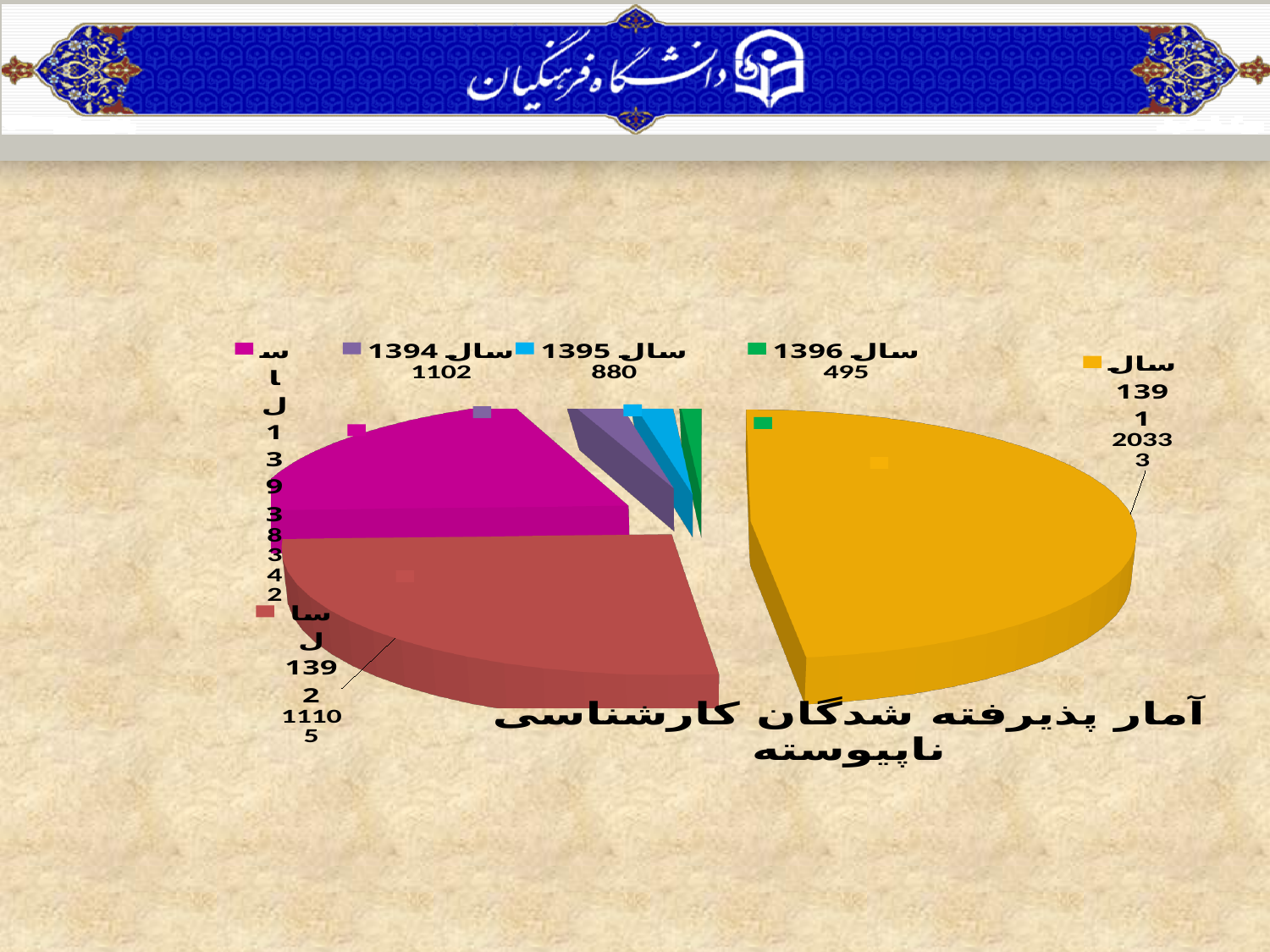
Which year has the smallest slice of the pie? سال 1396 What kind of chart is shown on the slide? pie chart Which is larger, the value for سال 1394 or the value for سال 1395? سال 1394 What is the value for سال 1393? 8342 How many slices does the pie chart have? 6 What is the value for سال 1394? 1102 What is the value for سال 1396? 495 What is the difference between the values for سال 1391 and سال 1392? 9228 What is the value for سال 1392? 11105 What is the value for سال 1391? 20333 What is the value for سال 1395? 880 Which year has the largest slice of the pie? سال 1391